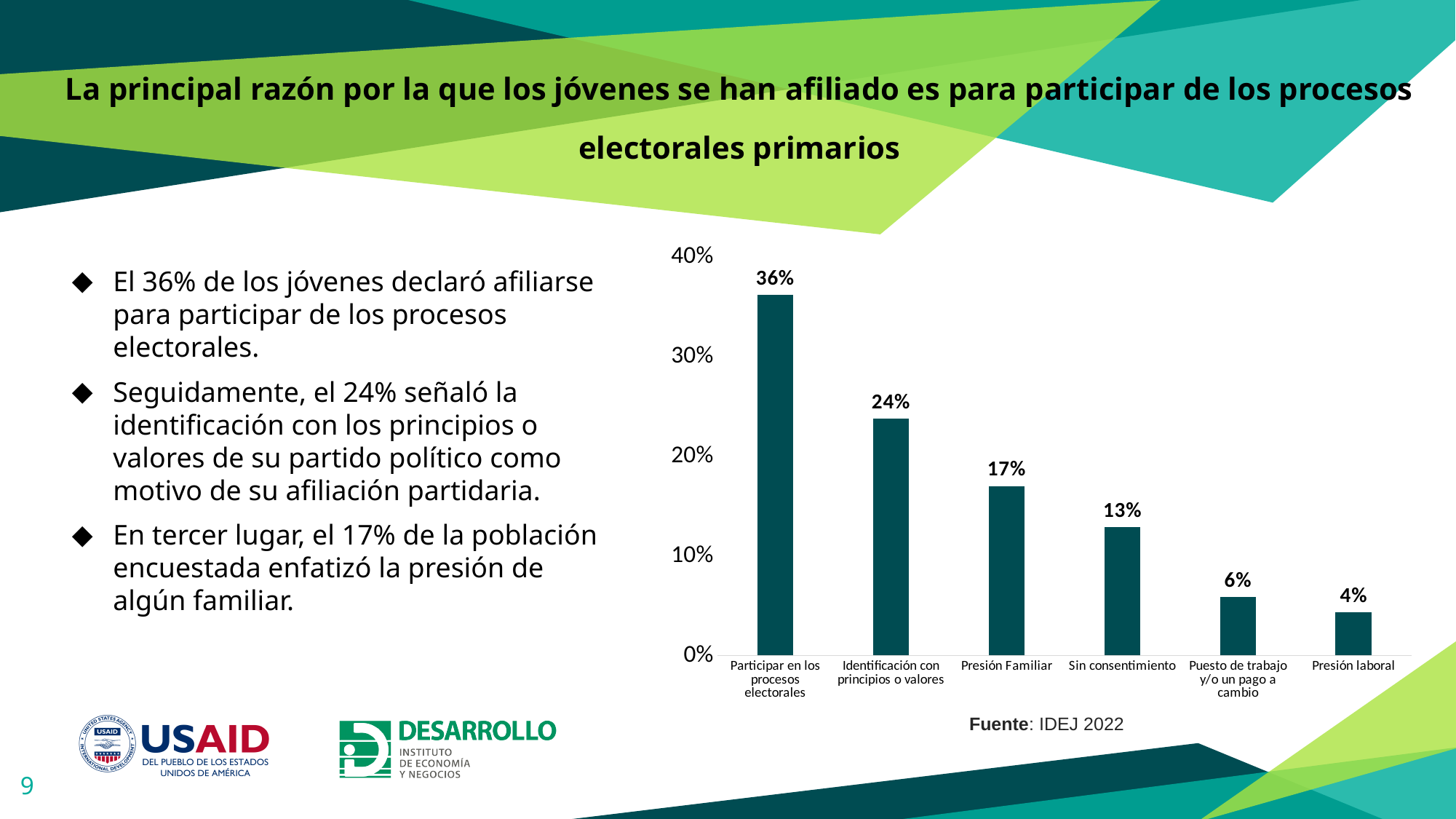
Which category has the highest value? Participar en los procesos electorales How many categories are shown in the chart? 6 What is the value for "Participar en los procesos electorales"? 36% Which is larger, the value for "Sin consentimiento" or the value for "Puesto de trabajo y/o un pago a cambio"? Sin consentimiento What kind of chart is shown on the slide? Bar chart What is the value for "Sin consentimiento"? 13% What is the difference between the values for "Participar en los procesos electorales" and "Identificación con principios o valores"? 12% Which category has the lowest value? Presión laboral What is the value for "Presión Familiar"? 17% What is the value for "Identificación con principios o valores"? 24% What is the value for "Presión laboral"? 4% Do the values rise or fall from left to right along the x axis? Fall